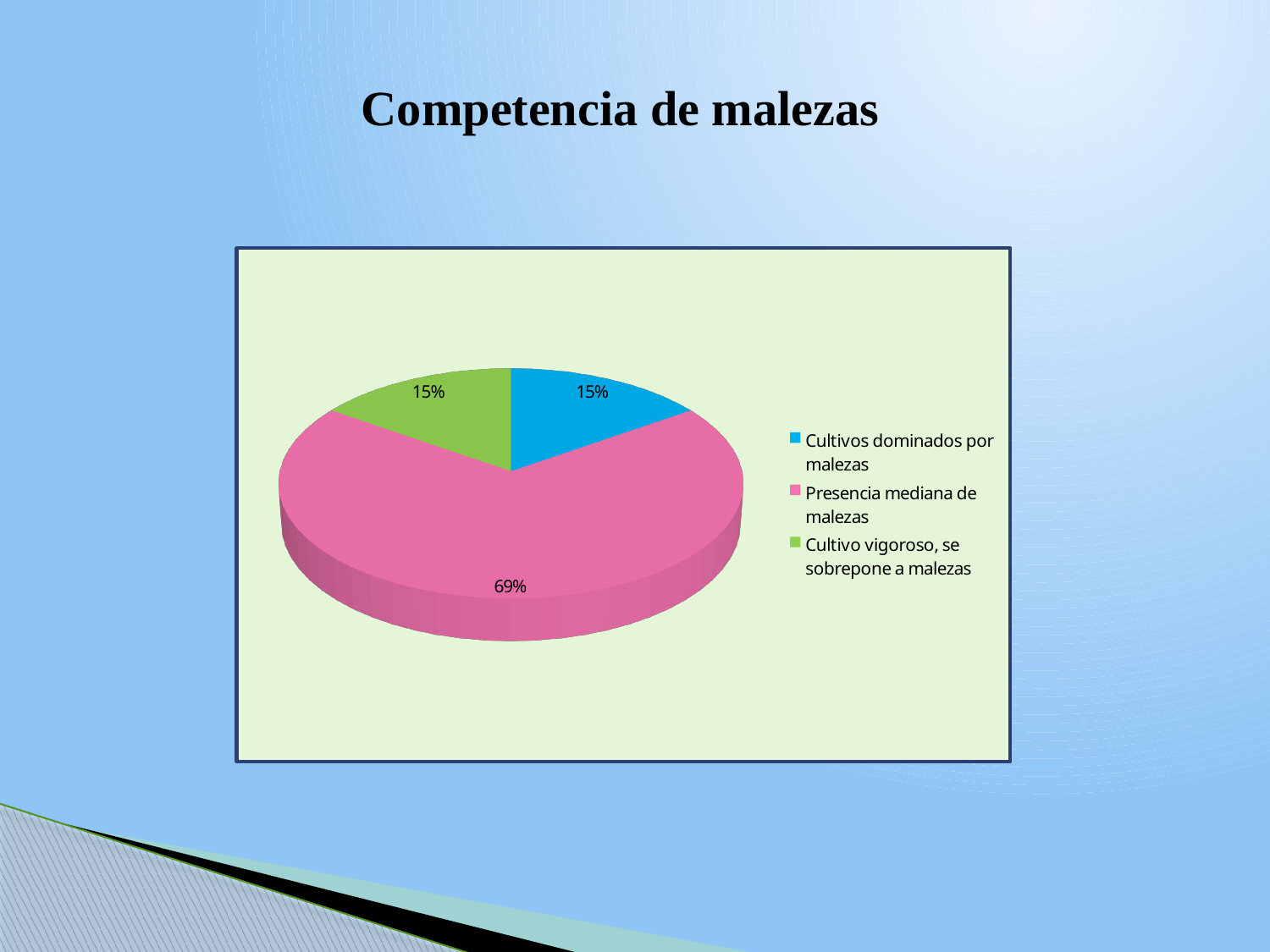
Which is larger: the share for "Presencia mediana de malezas" or the share for "Cultivo vigoroso, se sobrepone a malezas"? Presencia mediana de malezas What kind of chart is shown on the slide? pie chart Which category has the largest slice of the pie? Presencia mediana de malezas What share of the pie does "Presencia mediana de malezas" represent? 69% What share of the pie does "Cultivo vigoroso, se sobrepone a malezas" represent? 15% How many entries does the legend list? 3 What colour is the slice for "Cultivos dominados por malezas"? blue What share of the pie does "Cultivos dominados por malezas" represent? 15% How many slices does the pie chart have? 3 What is the title shown above the chart? Competencia de malezas What is the difference between the share for "Presencia mediana de malezas" and the share for "Cultivos dominados por malezas"? 54%